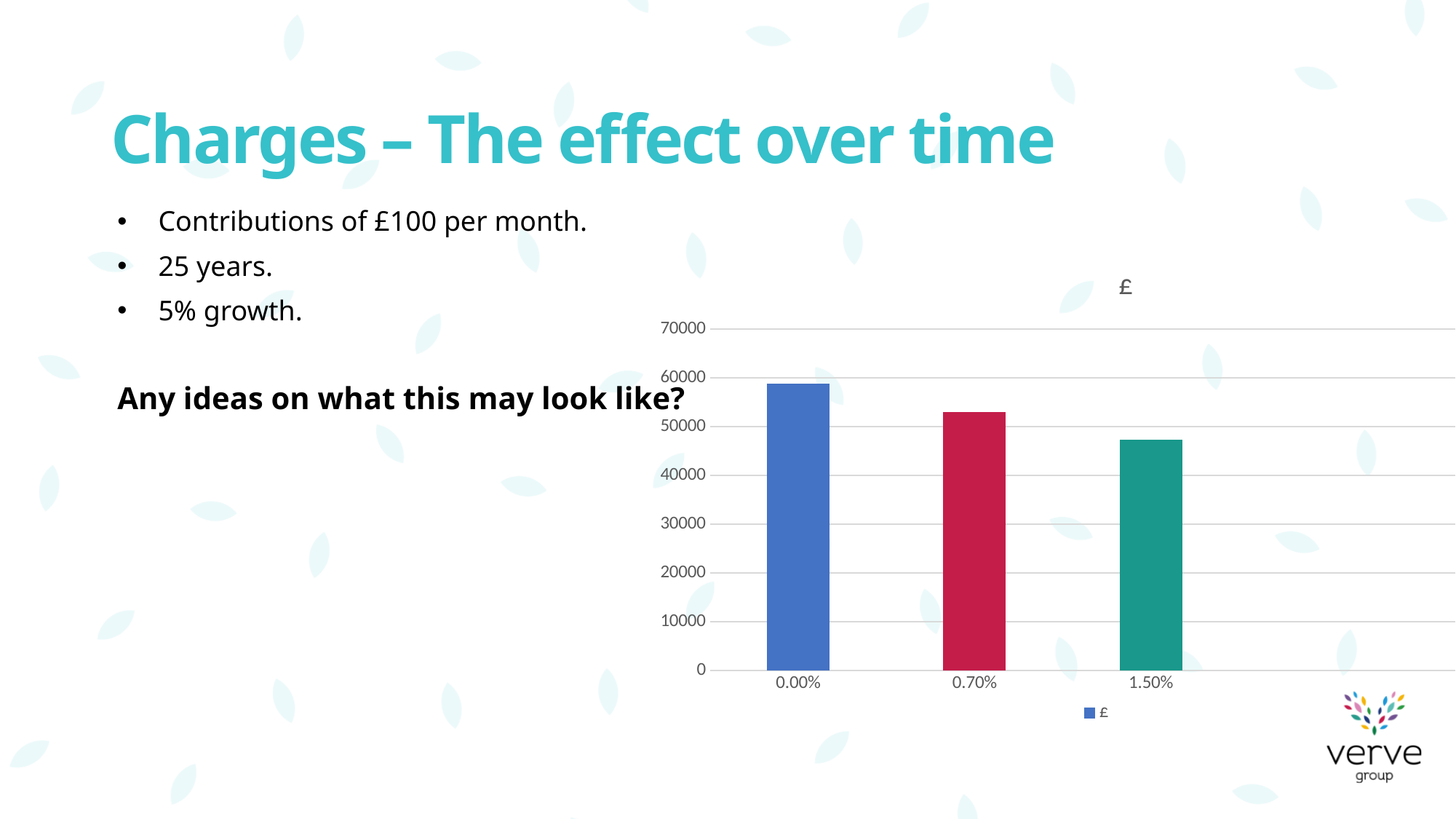
Which category has the lowest bar in the chart? 1.50% How many categories are plotted on the x axis of the chart? 3 What is the title of the chart? £ Do the bar values rise or fall as the charge percentage increases along the x axis? fall Is the value for 0.00% greater or less than 50000? greater What colour is the bar for the 0.70% category? red Which category has the highest bar in the chart? 0.00% Is the value for 0.70% greater or less than 60000? less Is the value for 1.50% greater or less than 50000? less What kind of chart is shown on the slide? bar chart How many series does the chart's legend list? 1 Which is larger, the value for 0.70% or the value for 1.50%? 0.70%